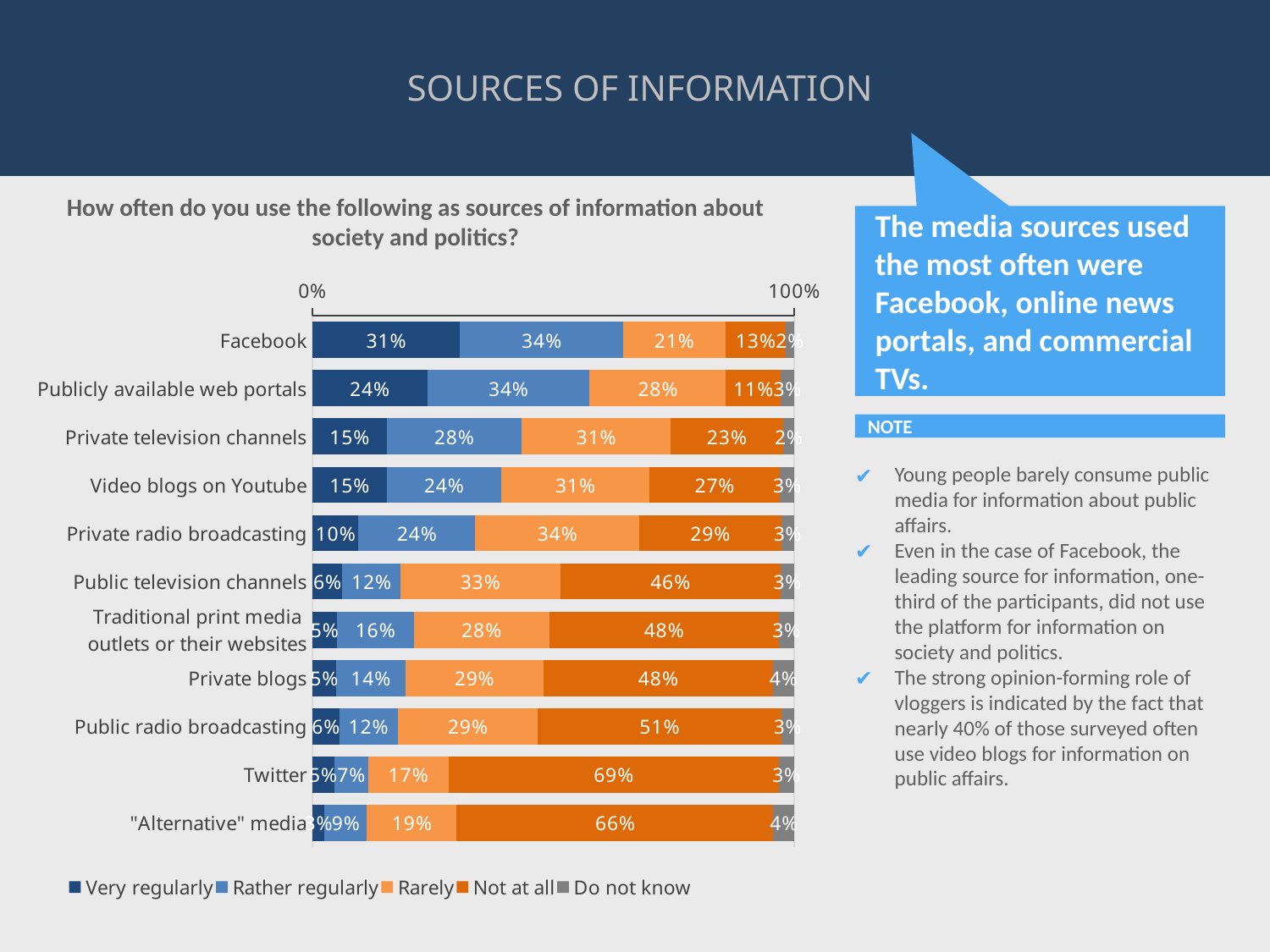
What is the difference between the "Not at all" values for Public radio broadcasting and Public television channels? 5% What is the "Rarely" value for Private radio broadcasting? 34% Which source has the highest "Not at all" value? Twitter What is the "Rather regularly" value for Video blogs on Youtube? 24% Which has a larger "Rarely" value: Private television channels or Publicly available web portals? Private television channels What is the "Not at all" value for Twitter? 69% Which source has the highest "Very regularly" value? Facebook What percentage of respondents use Facebook "Very regularly" as a source of information about society and politics? 31% How many sources of information are listed in the chart? 11 How many series does the legend list? 5 What type of chart is shown on the slide? Stacked bar chart Which legend entry is shown in grey? Do not know